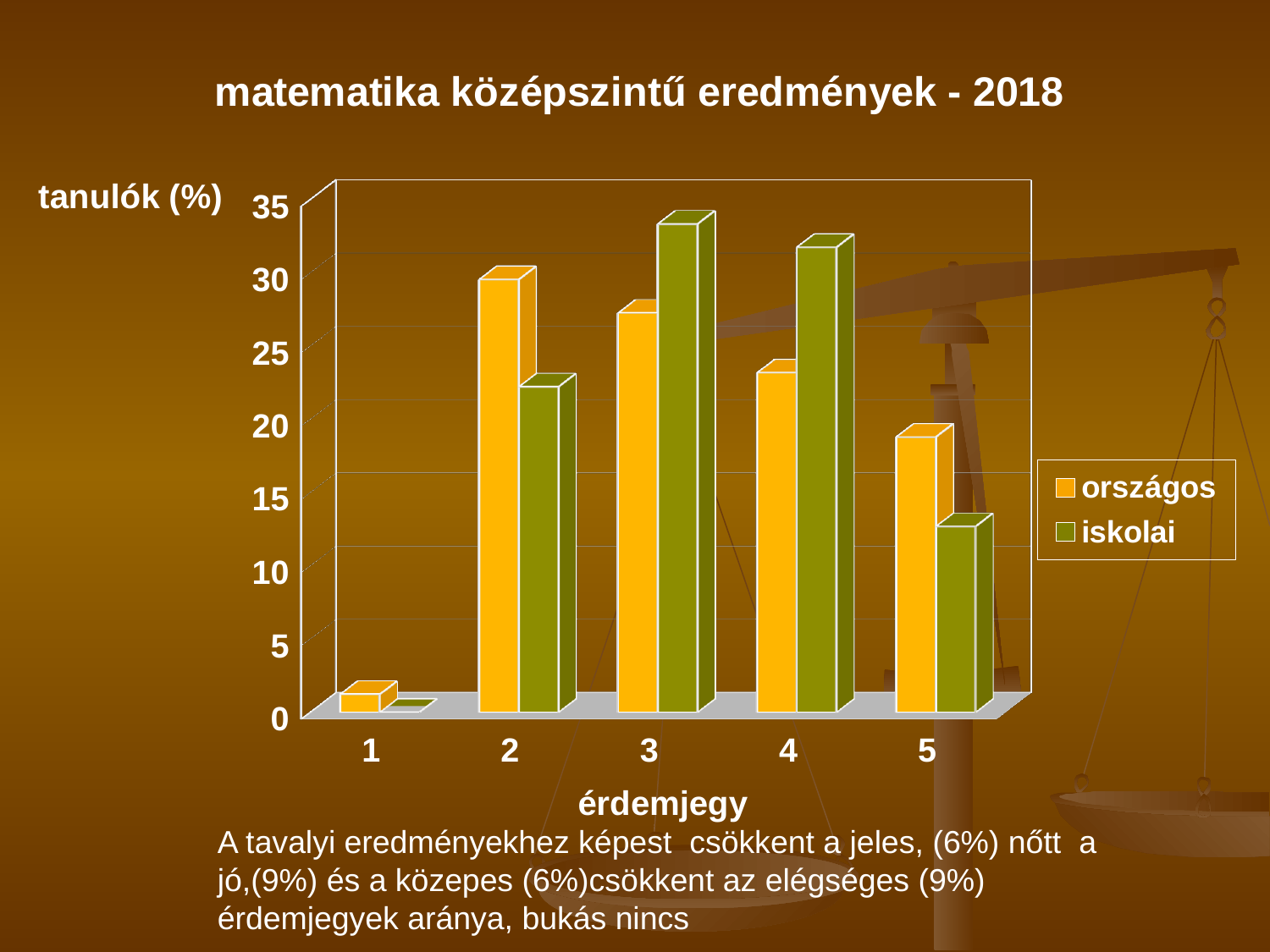
What kind of chart is shown on the slide? bar chart What is the label of the vertical axis? tanulók (%) For which grade is the országos value lowest? 1 For grade 3, which series has the larger value, országos or iskolai? iskolai How many grade categories (érdemjegy) are shown on the x axis? 5 Is the országos value for grade 2 greater or less than 25? greater For grade 5, which series has the larger value, országos or iskolai? országos How many series does the legend list? 2 For which grade is the országos value highest? 2 Is the iskolai value for grade 5 greater or less than 15? less For which grade is the iskolai value highest? 3 What is the title of the chart? matematika középszintű eredmények - 2018